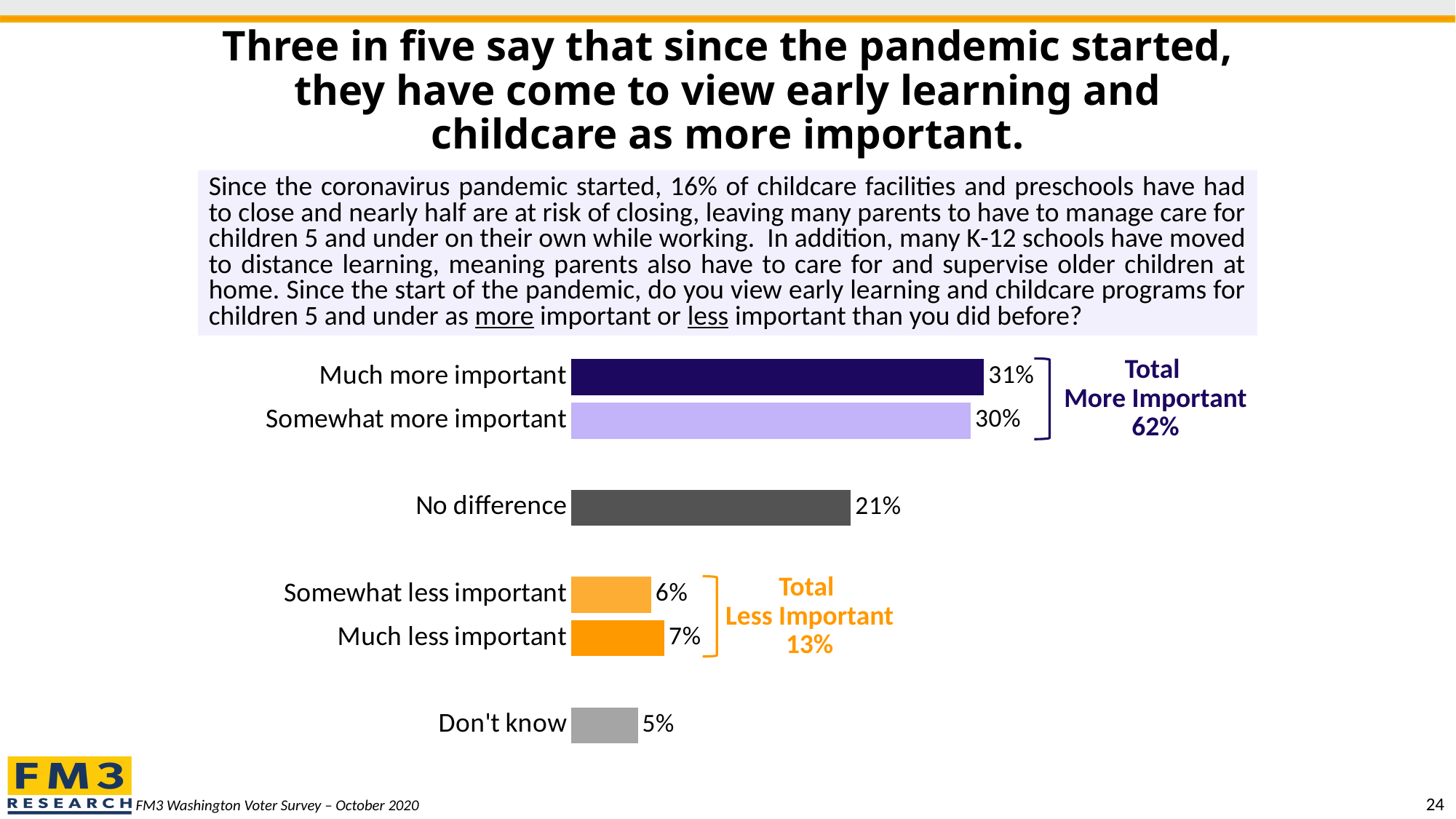
How many response categories are shown in the chart? 6 What type of chart is shown on the slide? Bar chart What percentage said 'No difference'? 21% What is the 'Total More Important' figure shown on the slide? 62% What percentage of respondents said early learning and childcare are 'Much more important'? 31% What is the value for 'Don't know'? 5% Which response category has the highest value? Much more important What is the value for 'Somewhat more important'? 30% Which is larger, 'Somewhat less important' or 'Much less important'? Much less important What is the difference between 'Much more important' and 'No difference'? 10 percentage points Which response category has the lowest value? Don't know What is the 'Total Less Important' figure shown on the slide? 13%